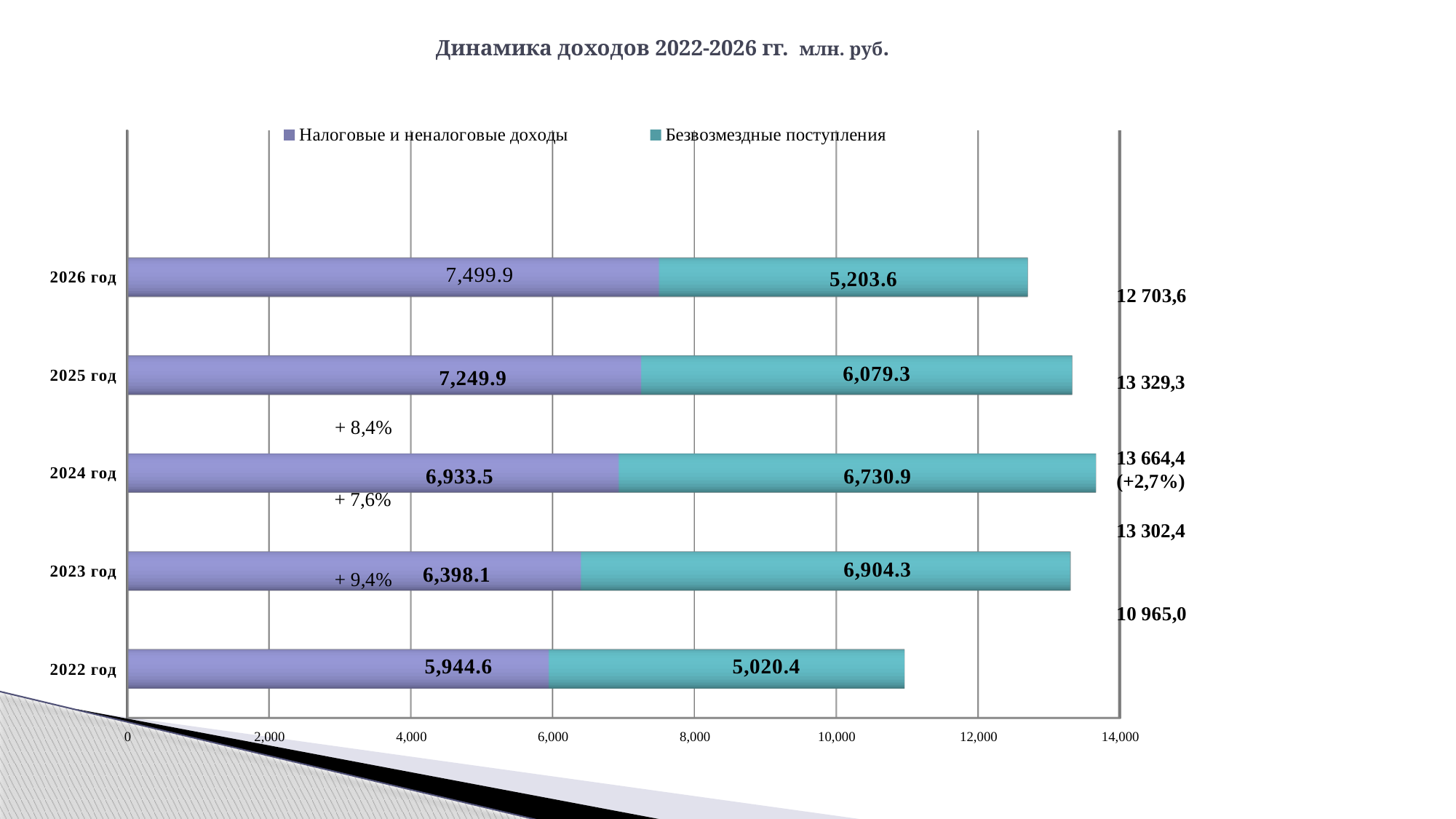
Which year has the highest value of Налоговые и неналоговые доходы? 2026 год How many years are plotted on the chart? 5 What is the value of Налоговые и неналоговые доходы for 2026 год? 7,499.9 What is the value of Безвозмездные поступления for 2023 год? 6,904.3 How many series does the legend list? 2 What is the total of the stacked bar for 2024 год? 13 664,4 What is the total of the stacked bar for 2022 год? 10 965,0 In 2024 год, which is larger: Налоговые и неналоговые доходы or Безвозмездные поступления? Налоговые и неналоговые доходы Do the values of Налоговые и неналоговые доходы rise or fall from 2022 год to 2026 год? rise What is the difference between Налоговые и неналоговые доходы in 2025 год and 2024 год? 316.4 What kind of chart is shown on the slide? bar chart Which year has the lowest value of Безвозмездные поступления? 2022 год